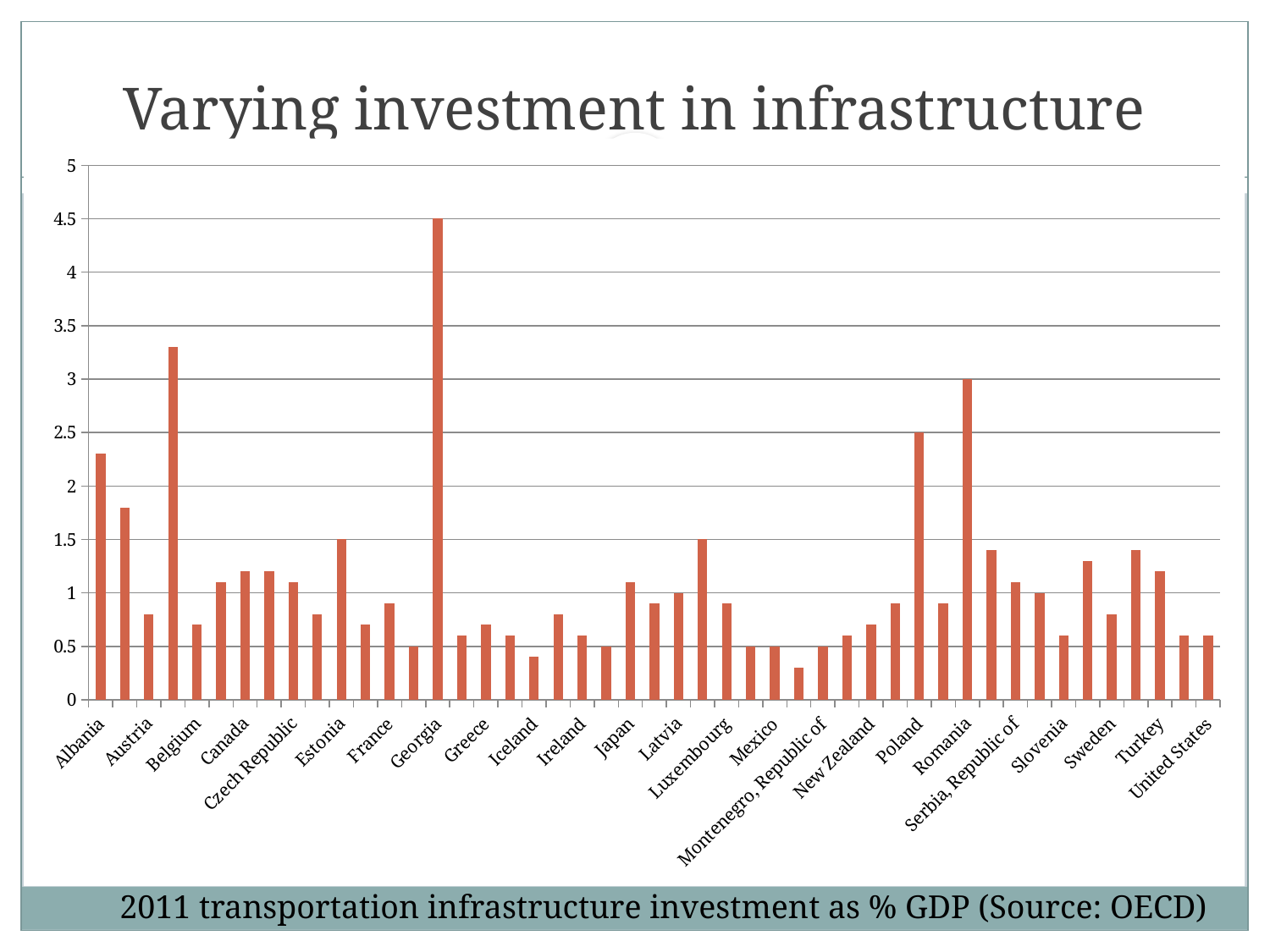
What is the value for Estonia? 1.5 What is the value for Georgia? 4.5 Is the value for Albania greater or less than 2? greater What is the title of the slide? Varying investment in infrastructure What type of chart is shown on the slide? bar chart What is the value for Poland? 2.5 What is the difference between the values for Georgia and Romania? 1.5 According to the caption, what year and source does the data come from? 2011, OECD Which is larger, the value for Poland or the value for Romania? Romania What is the value for Romania? 3 Is the value for Iceland greater or less than 0.5? less Which country has the highest transportation infrastructure investment as % GDP? Georgia